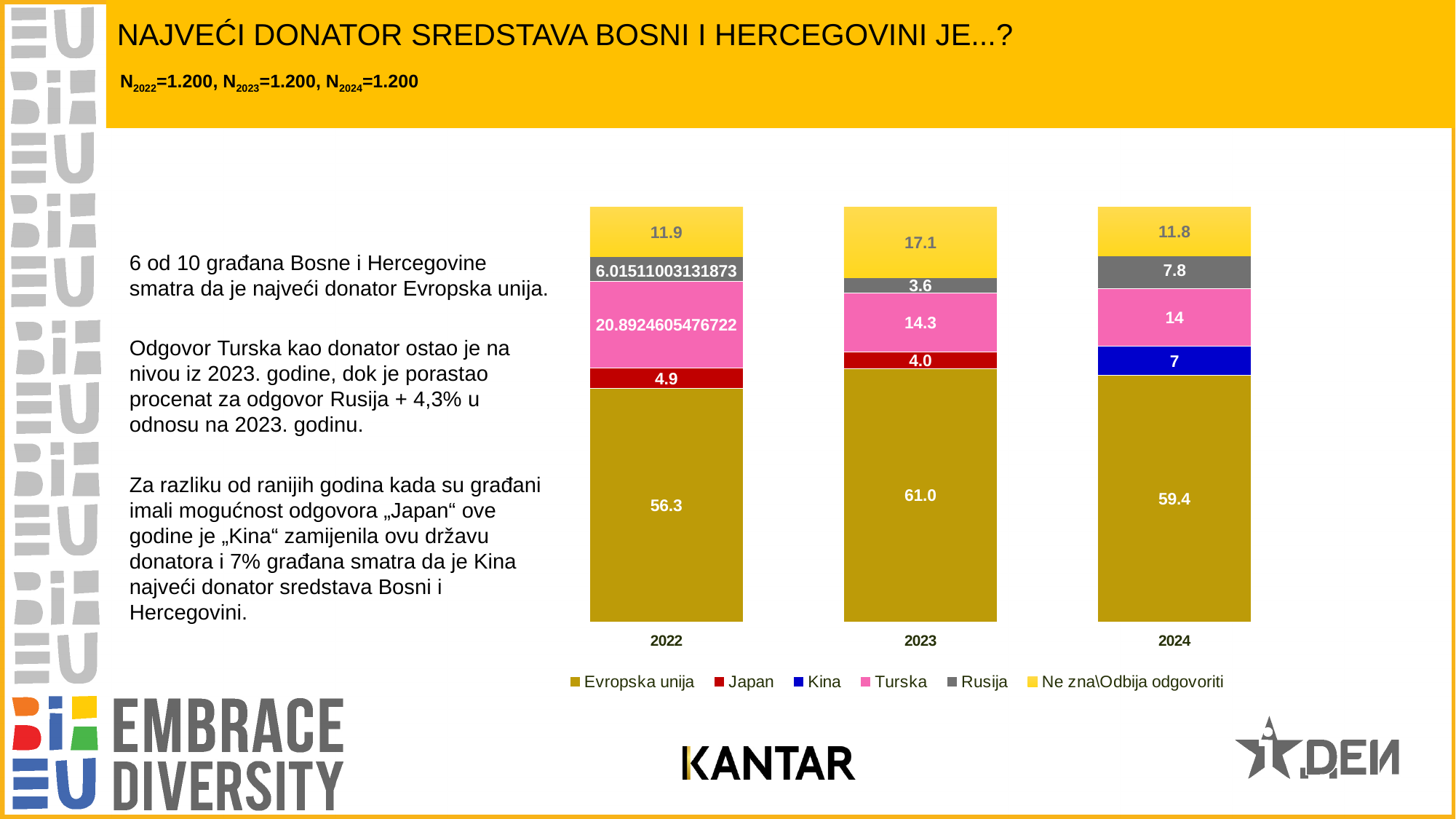
Does the value for Turska rise or fall from 2022 to 2024? Fall In which year is the value for Rusija the lowest? 2023 How many series does the legend list? 6 What is the value for Evropska unija in 2022? 56.3 What is the value for Kina in 2024? 7 What is the difference between the Evropska unija values for 2023 and 2022? 4.7 What is the value for Rusija in 2024? 7.8 How many years (categories) are shown on the x axis? 3 What type of chart is shown on the slide? Stacked bar chart Which is larger in 2022, the value for Turska or the value for Ne zna\Odbija odgovoriti? Turska What is the value for Ne zna\Odbija odgovoriti in 2023? 17.1 In which year is the value for Evropska unija the highest? 2023